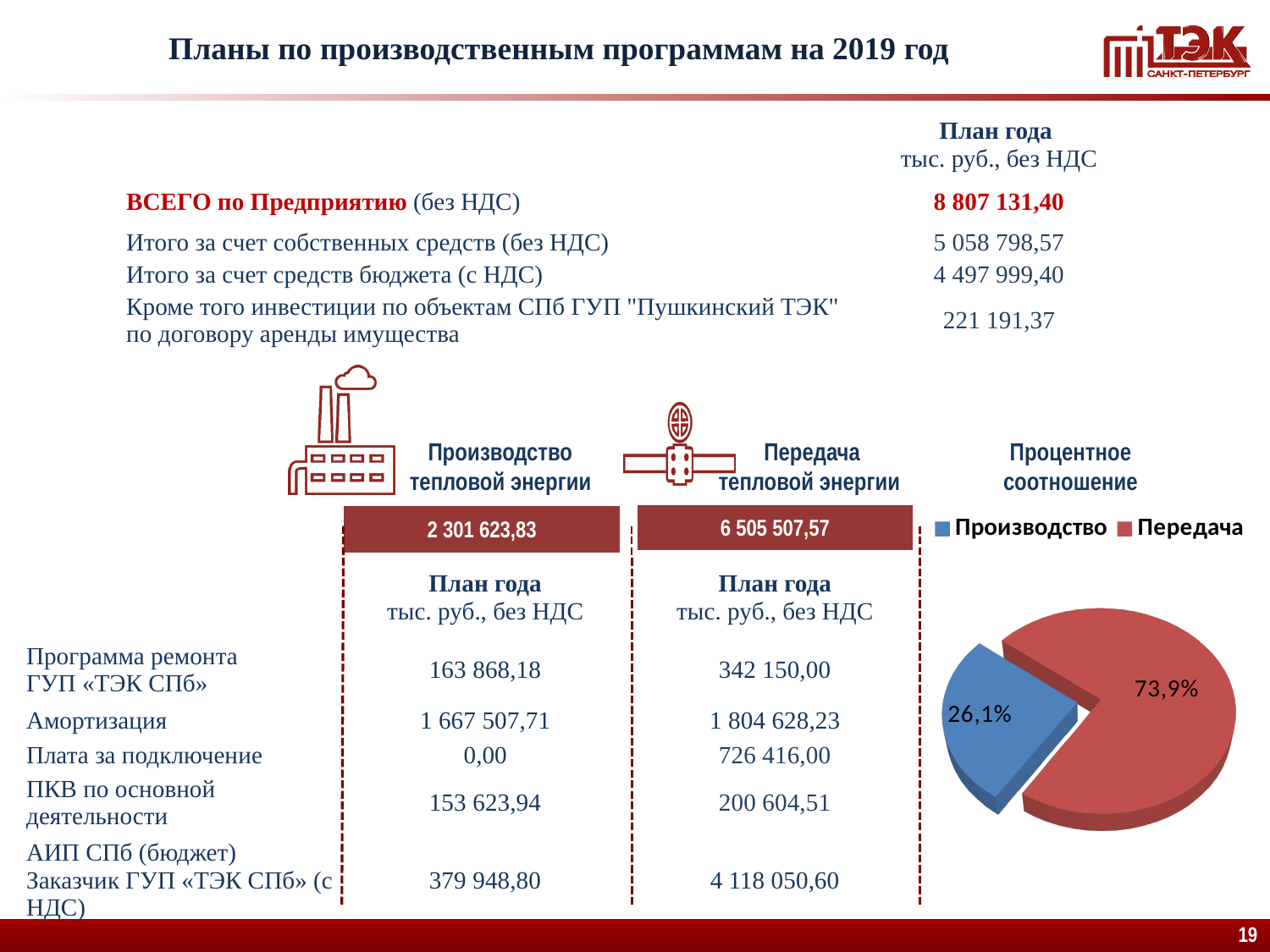
In the pie chart "Процентное соотношение", which is larger: Производство or Передача? Передача What type of chart is shown under the heading "Процентное соотношение"? Pie chart In the pie chart "Процентное соотношение", what share is shown for Производство? 26,1% In the pie chart "Процентное соотношение", what share is shown for Передача? 73,9% In the pie chart "Процентное соотношение", which slice is the smallest? Производство In the pie chart "Процентное соотношение", what colour is the Передача slice? Red In the pie chart "Процентное соотношение", by how many percentage points does Передача exceed Производство? 47,8 How many slices does the pie chart "Процентное соотношение" have? 2 In the pie chart "Процентное соотношение", which slice is the largest? Передача How many entries does the legend of the pie chart "Процентное соотношение" list? 2 In the pie chart "Процентное соотношение", what colour is the Производство slice? Blue